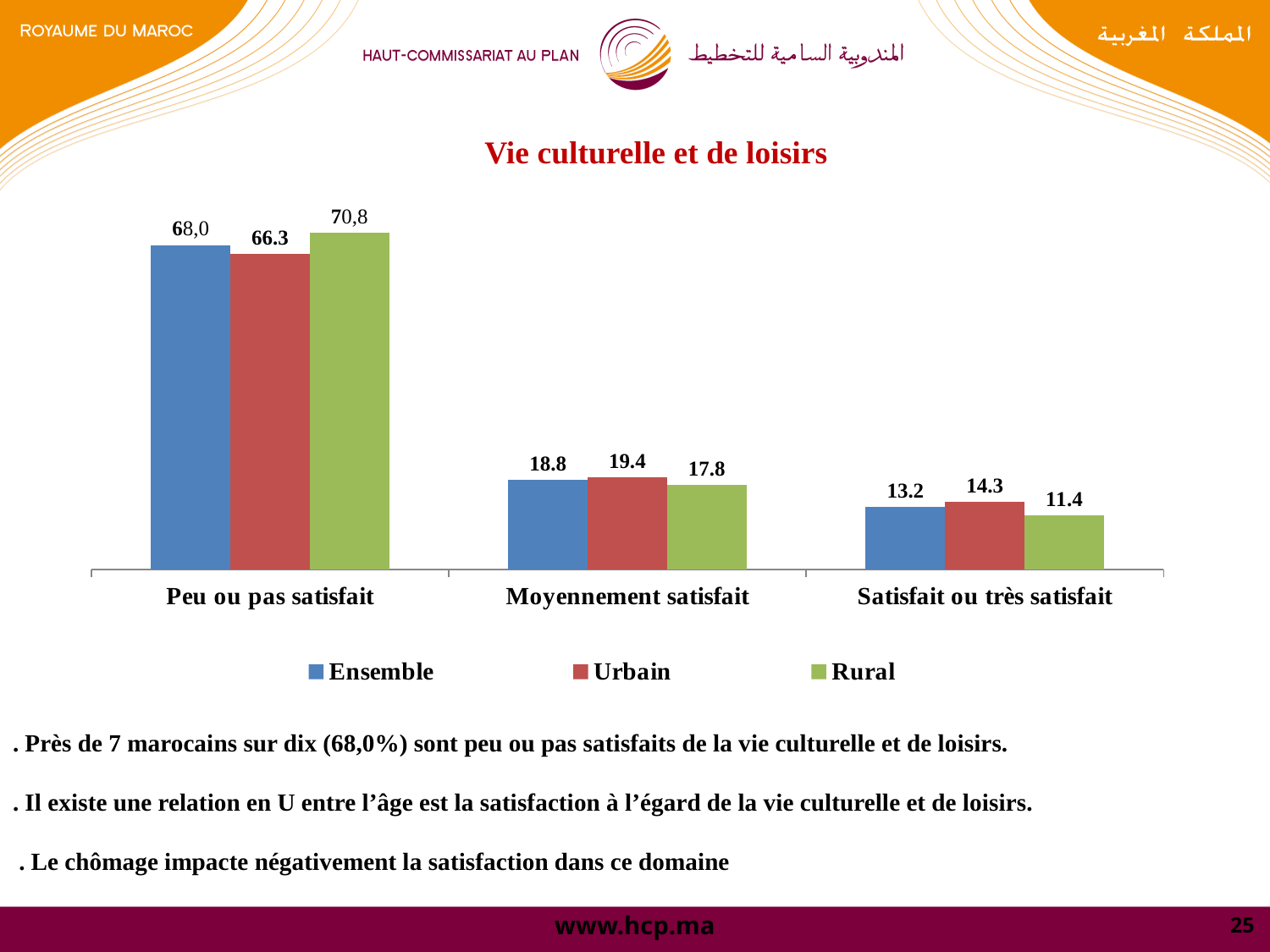
What is the value for Rural in the 'Satisfait ou très satisfait' category? 11.4 What is the difference between the Urbain and Rural values in the 'Satisfait ou très satisfait' category? 2.9 What is the value for Ensemble in the 'Peu ou pas satisfait' category? 68,0 Which series has the highest value in the 'Peu ou pas satisfait' category? Rural What is the value for Rural in the 'Peu ou pas satisfait' category? 70,8 What is the value for Urbain in the 'Moyennement satisfait' category? 19.4 What is the difference between the Rural and Ensemble values in the 'Peu ou pas satisfait' category? 2,8 What type of chart is shown on the slide? bar chart How many series does the legend list? 3 Which is larger in the 'Moyennement satisfait' category: Urbain or Rural? Urbain Which series has the lowest value in the 'Satisfait ou très satisfait' category? Rural How many categories are shown on the x axis? 3